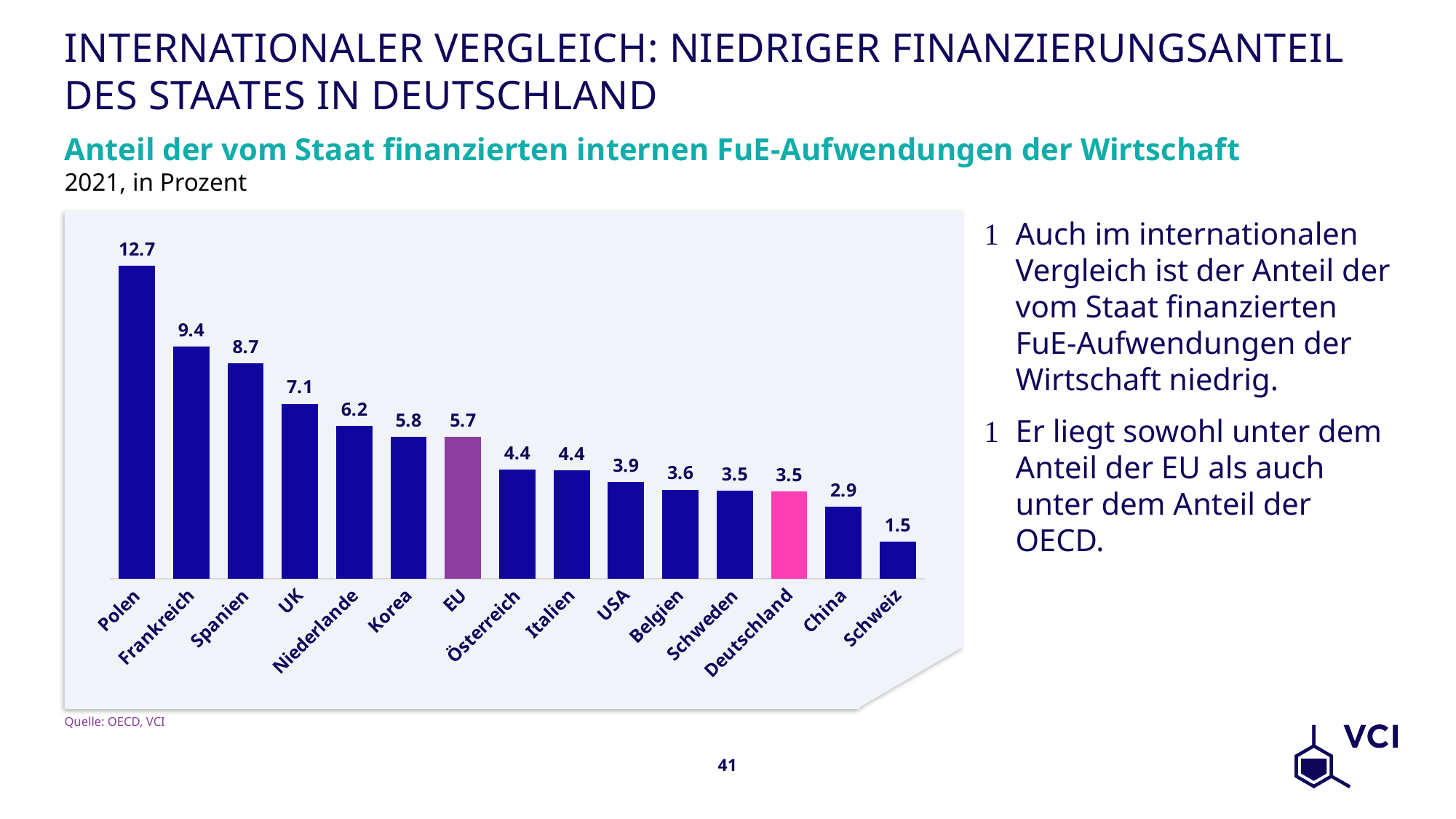
What is the value for Polen? 12.7 Which is larger, the value for UK or the value for Niederlande? UK Which category has the lowest value? Schweiz What is the difference between the values for Frankreich and Spanien? 0.7 Which bar is highlighted in pink? Deutschland What is the value for Korea? 5.8 How many categories are shown in the chart? 15 What is the value for Deutschland? 3.5 What is the difference between the values for EU and Deutschland? 2.2 Which category has the highest value? Polen What is the value for EU? 5.7 What kind of chart is shown on the slide? Bar chart